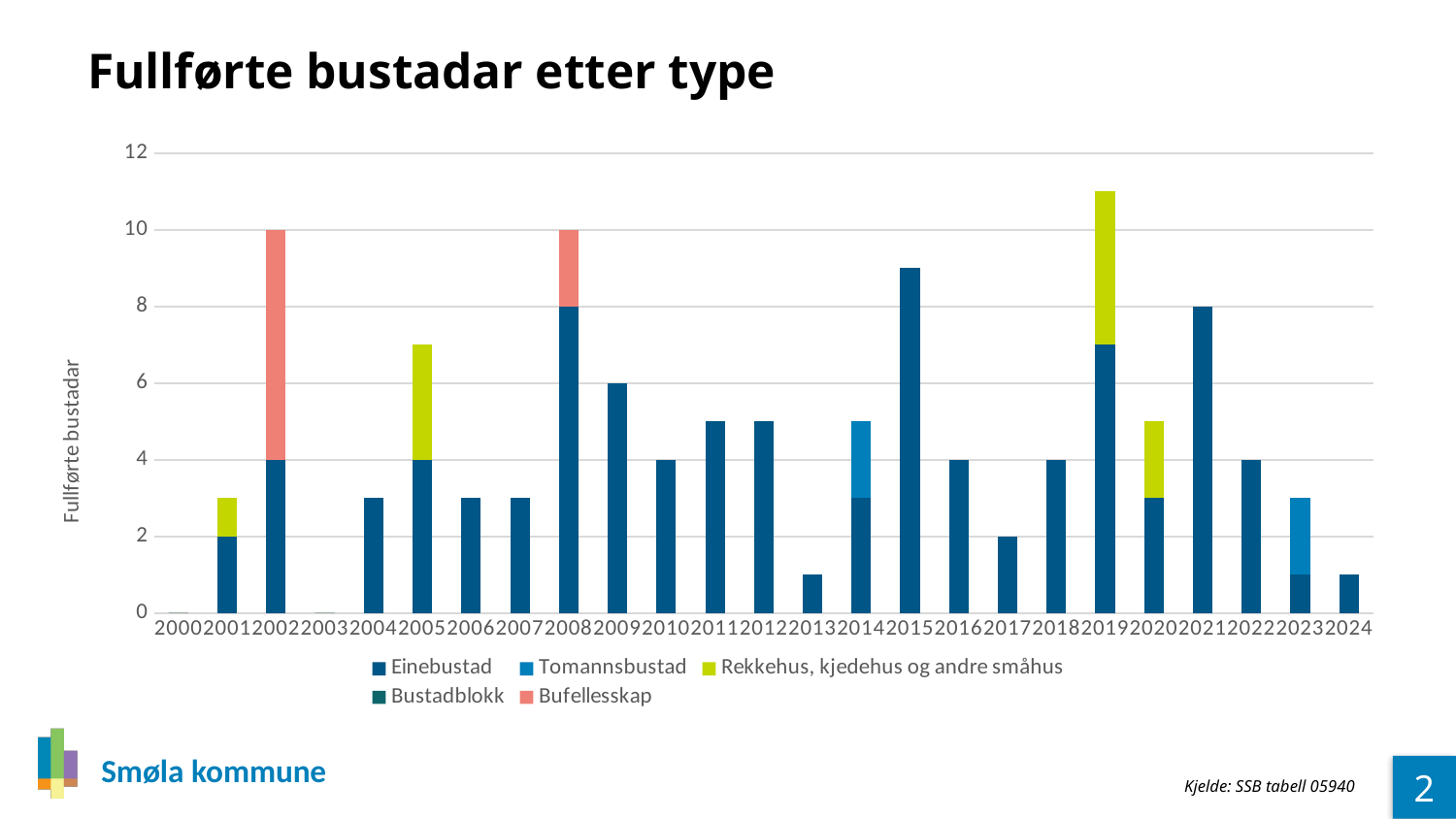
What is the difference between the total bar heights for 2002 and 2008? 0 What kind of chart is shown on the slide? Stacked bar chart What is the total number of completed dwellings in 2009? 6 How many series does the legend list? 5 Is the value for 2015 greater or less than 8? greater What is the source cited below the chart? SSB tabell 05940 Which year has the tallest bar? 2019 How many years are shown on the x axis? 25 What is the total height of the stacked bar for 2002? 10 Is the value for 2013 greater or less than 2? less Which year has the taller bar, 2002 or 2009? 2002 What is the value for Einebustad in 2008? 8